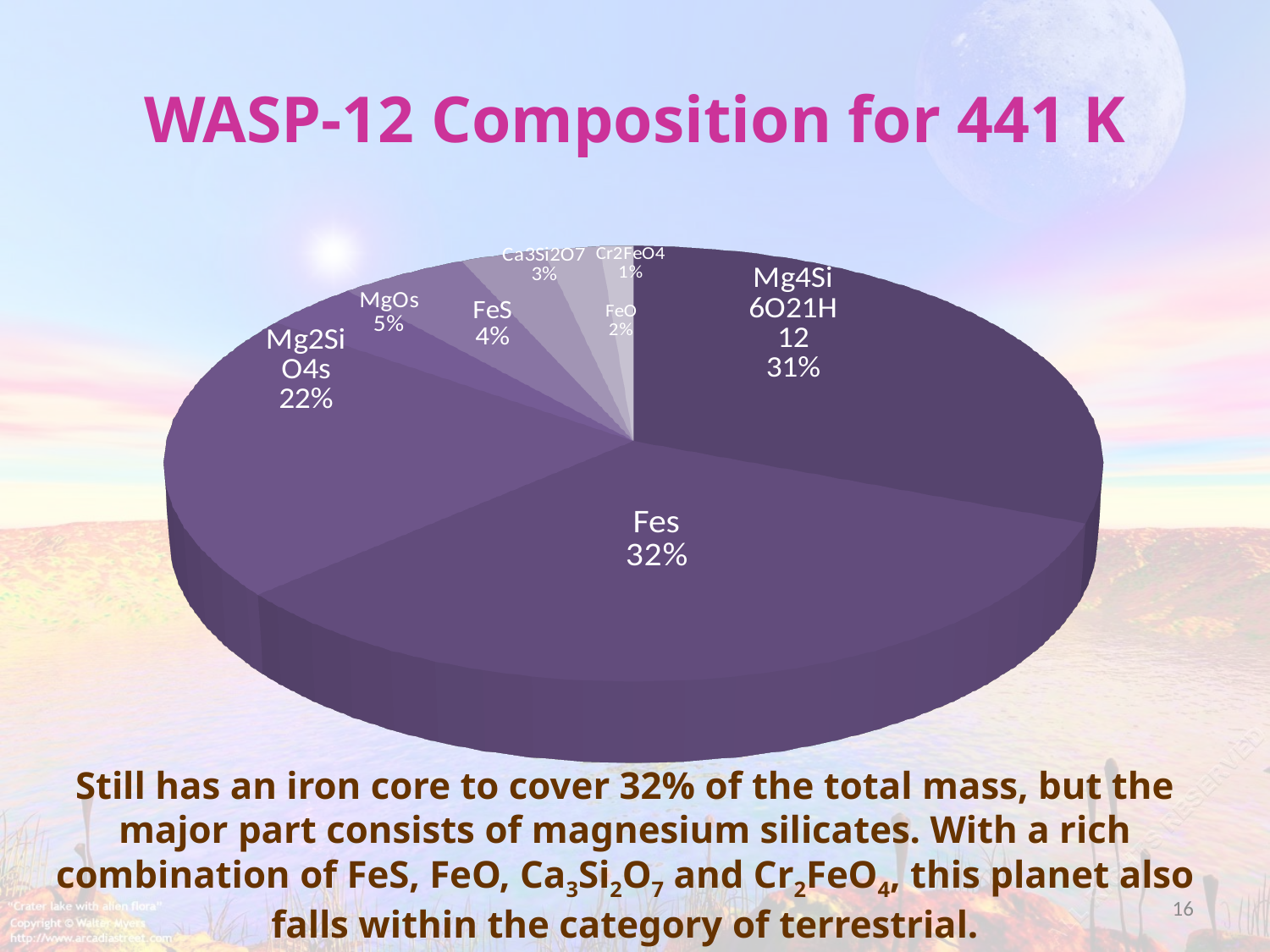
What percentage does the MgOs slice represent? 5% What is the difference in percentage points between the Mg2SiO4s slice and the MgOs slice? 17 What kind of chart is shown on the slide? pie chart Which slice has the smallest share of the pie? Cr2FeO4 What percentage does the Fes slice represent? 32% What percentage does the Mg4Si6O21H12 slice represent? 31% Which slice has the largest share of the pie? Fes What percentage does the Mg2SiO4s slice represent? 22% What percentage does the Cr2FeO4 slice represent? 1% Which slice is larger, Ca3Si2O7 or FeO? Ca3Si2O7 What is the title of the chart? WASP-12 Composition for 441 K How many slices does the pie chart have? 8